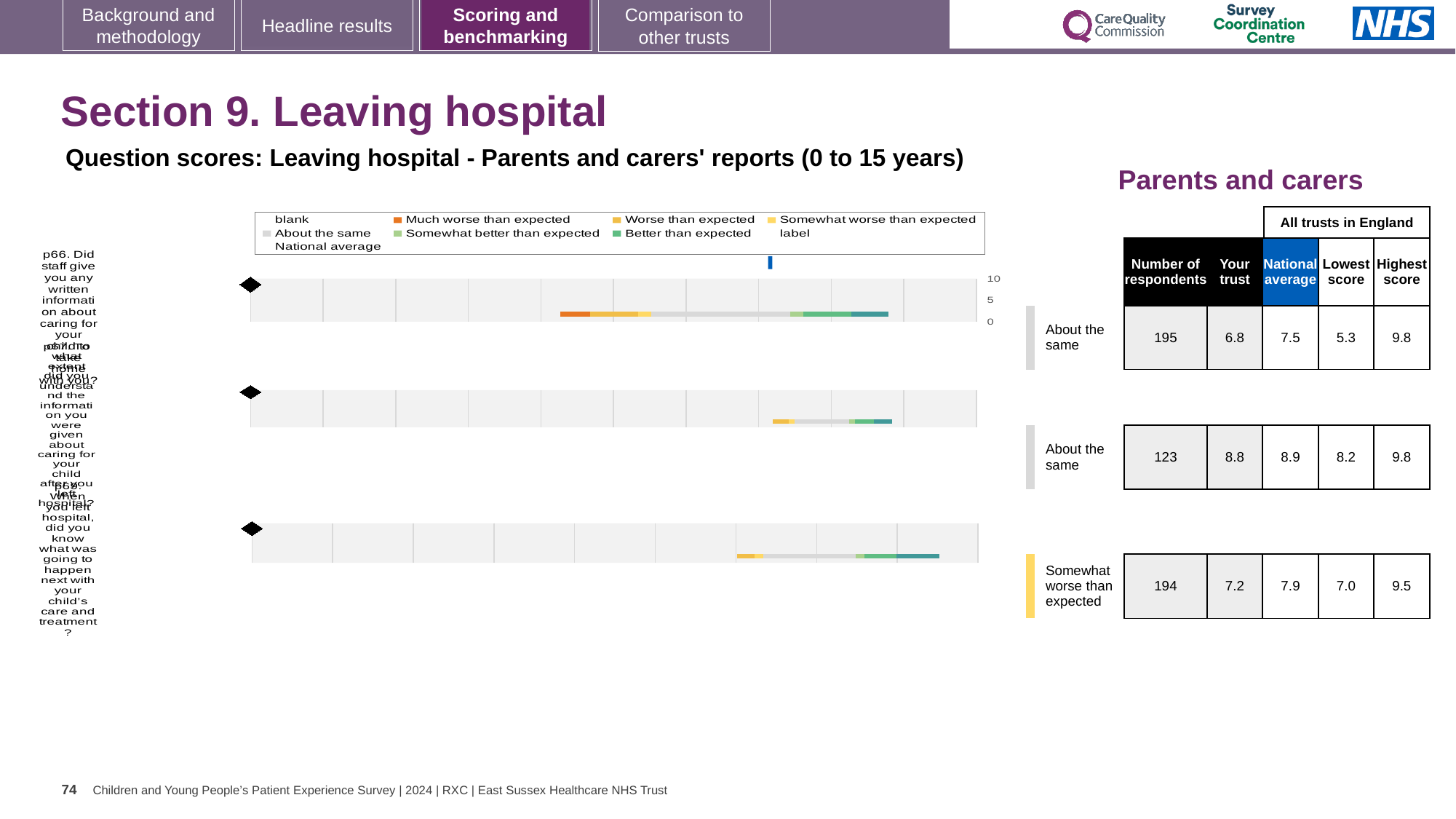
In the chart legend, what colour represents 'About the same'? grey In the table beside the charts, what is the lowest score for the middle chart row? 8.2 In the table beside the charts, what is the 'Your trust' score for the top chart row? 6.8 For the top chart row, which is larger: the 'Your trust' score or the national average? National average In the table beside the charts, how many respondents are listed for the bottom chart row? 194 What kind of chart is used to show the question scores on this slide? bar chart For the bottom chart row, what is the difference between the highest score (9.5) and the lowest score (7.0)? 2.5 What is the title printed above the charts? Question scores: Leaving hospital - Parents and carers' reports (0 to 15 years) Which chart row has the highest 'Your trust' score in the table? the middle row (8.8) How many separate chart rows (questions) are plotted on the slide? 3 What benchmark category is shown for the bottom chart row? Somewhat worse than expected In the table beside the charts, what is the national average for the top chart row? 7.5